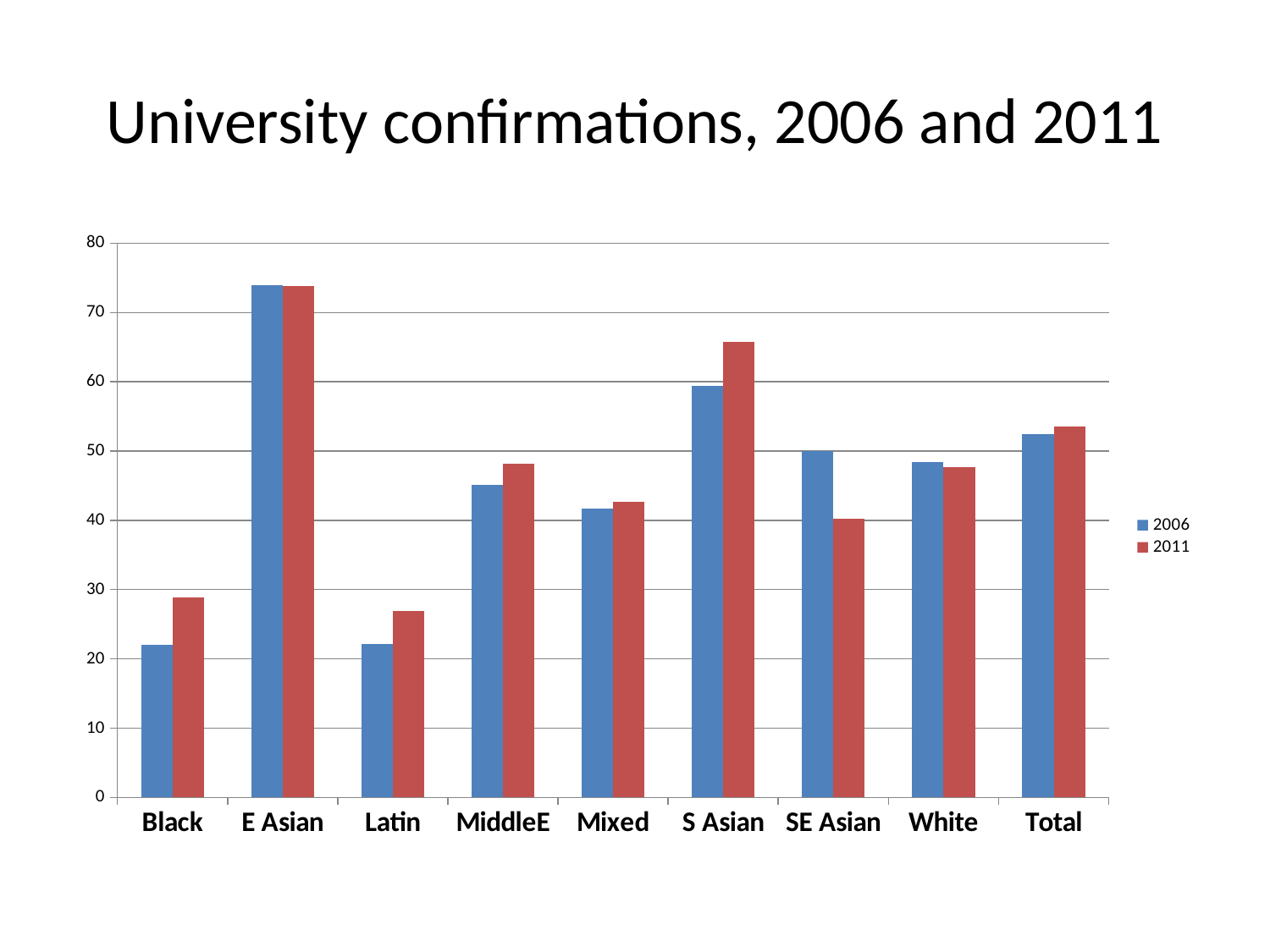
How many categories are shown on the x axis? 9 Which category has the highest value for 2006? E Asian What kind of chart is shown on the slide? bar chart For SE Asian, which year has the larger value, 2006 or 2011? 2006 How many series does the legend list? 2 Is the 2006 value for Black greater or less than 30? less Is the 2006 value for E Asian greater or less than 70? greater Is the 2011 value for SE Asian greater or less than 50? less Which category has the highest value for 2011? E Asian What is the title of the chart? University confirmations, 2006 and 2011 For S Asian, which year has the larger value, 2006 or 2011? 2011